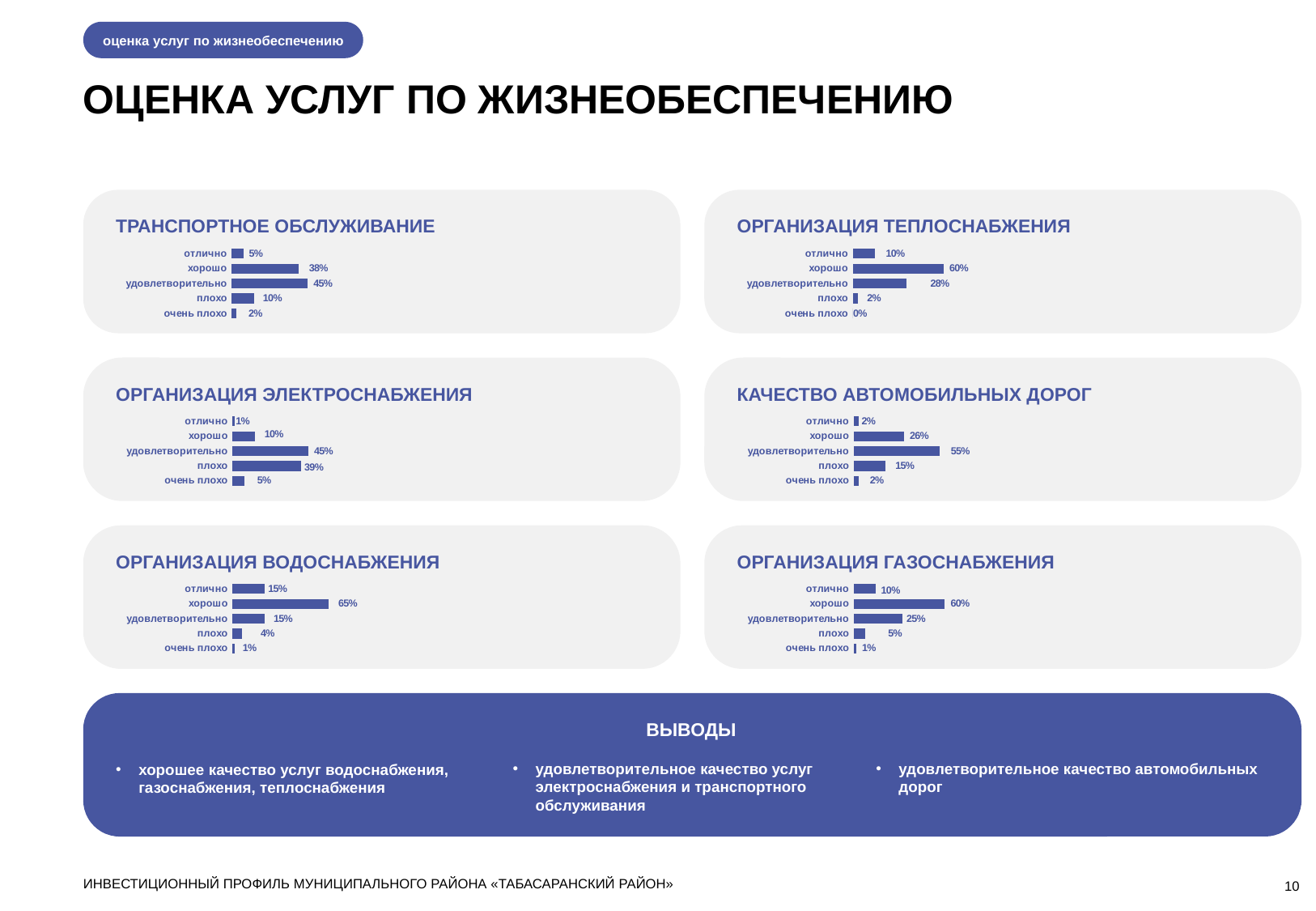
What kind of chart is the chart titled ТРАНСПОРТНОЕ ОБСЛУЖИВАНИЕ? bar chart In the chart titled ОРГАНИЗАЦИЯ ТЕПЛОСНАБЖЕНИЯ, which category has the highest value? хорошо In the chart titled ОРГАНИЗАЦИЯ ВОДОСНАБЖЕНИЯ, what is the value for хорошо? 65% In the chart titled ОРГАНИЗАЦИЯ ТЕПЛОСНАБЖЕНИЯ, what is the value for очень плохо? 0% In the chart titled КАЧЕСТВО АВТОМОБИЛЬНЫХ ДОРОГ, which is larger, хорошо or плохо? хорошо How many categories does the chart titled ОРГАНИЗАЦИЯ ГАЗОСНАБЖЕНИЯ show? 5 In the chart titled ОРГАНИЗАЦИЯ ЭЛЕКТРОСНАБЖЕНИЯ, which category has the lowest value? отлично In the chart titled ОРГАНИЗАЦИЯ ВОДОСНАБЖЕНИЯ, what is the difference between хорошо and отлично? 50% In the chart titled КАЧЕСТВО АВТОМОБИЛЬНЫХ ДОРОГ, what is the value for удовлетворительно? 55% In the chart titled ОРГАНИЗАЦИЯ ЭЛЕКТРОСНАБЖЕНИЯ, what is the difference between удовлетворительно and плохо? 6% In the chart titled ОРГАНИЗАЦИЯ ГАЗОСНАБЖЕНИЯ, what is the value for удовлетворительно? 25% In the chart titled ТРАНСПОРТНОЕ ОБСЛУЖИВАНИЕ, what is the value for удовлетворительно? 45%